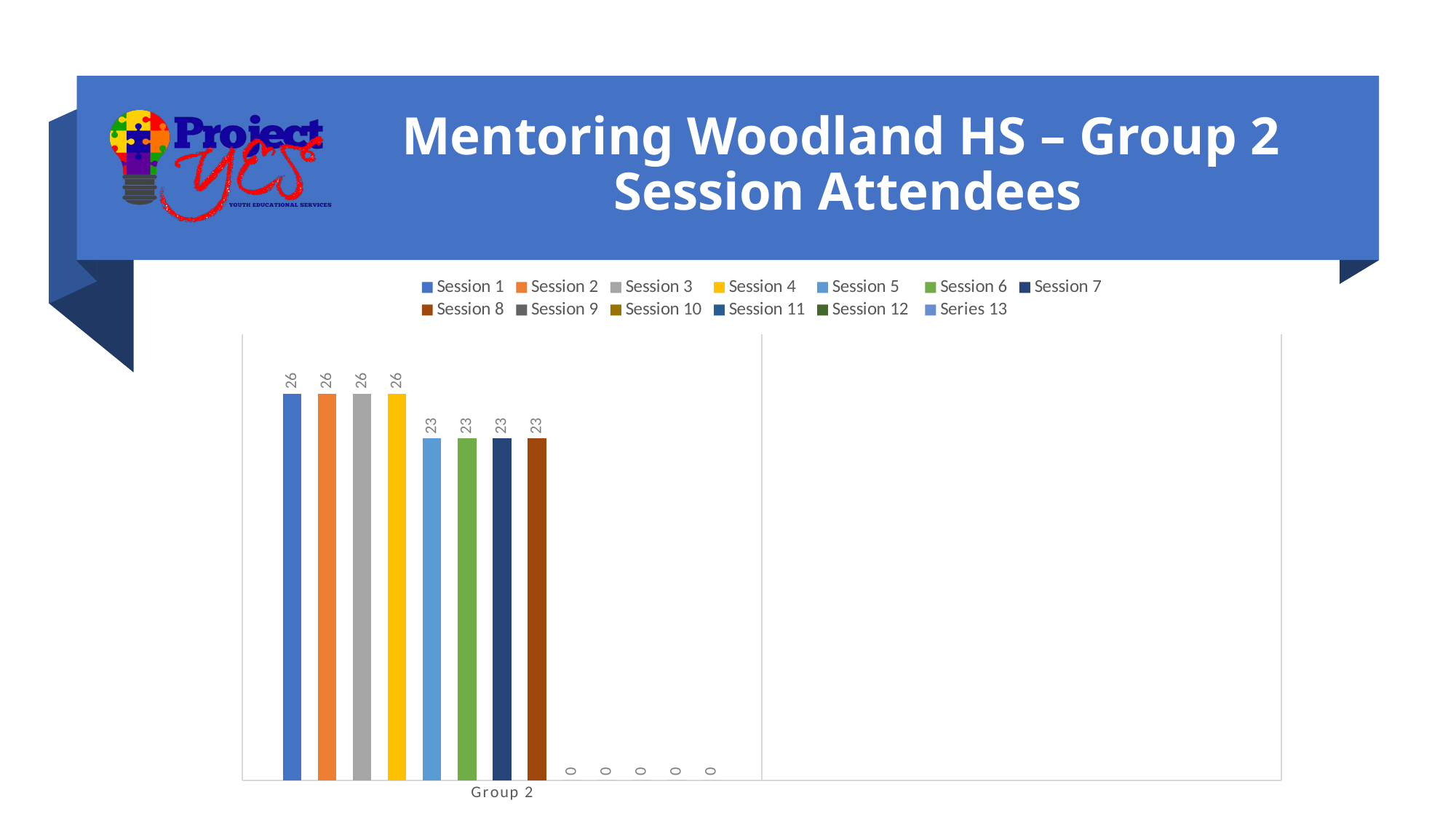
How many series does the legend list? 13 What kind of chart is shown on the slide? bar chart How many series have a value of 0? 5 What is the value for Session 1 in Group 2? 26 What is the value for Session 5 in Group 2? 23 Which is larger, the value for Session 2 or the value for Session 7? Session 2 What is the value for Session 10 in Group 2? 0 What is the value for Session 8 in Group 2? 23 What is the category label shown on the x axis? Group 2 What is the title of the slide containing the chart? Mentoring Woodland HS – Group 2 Session Attendees What is the difference between the value for Session 4 and the value for Session 6? 3 How many series have a value of 26? 4